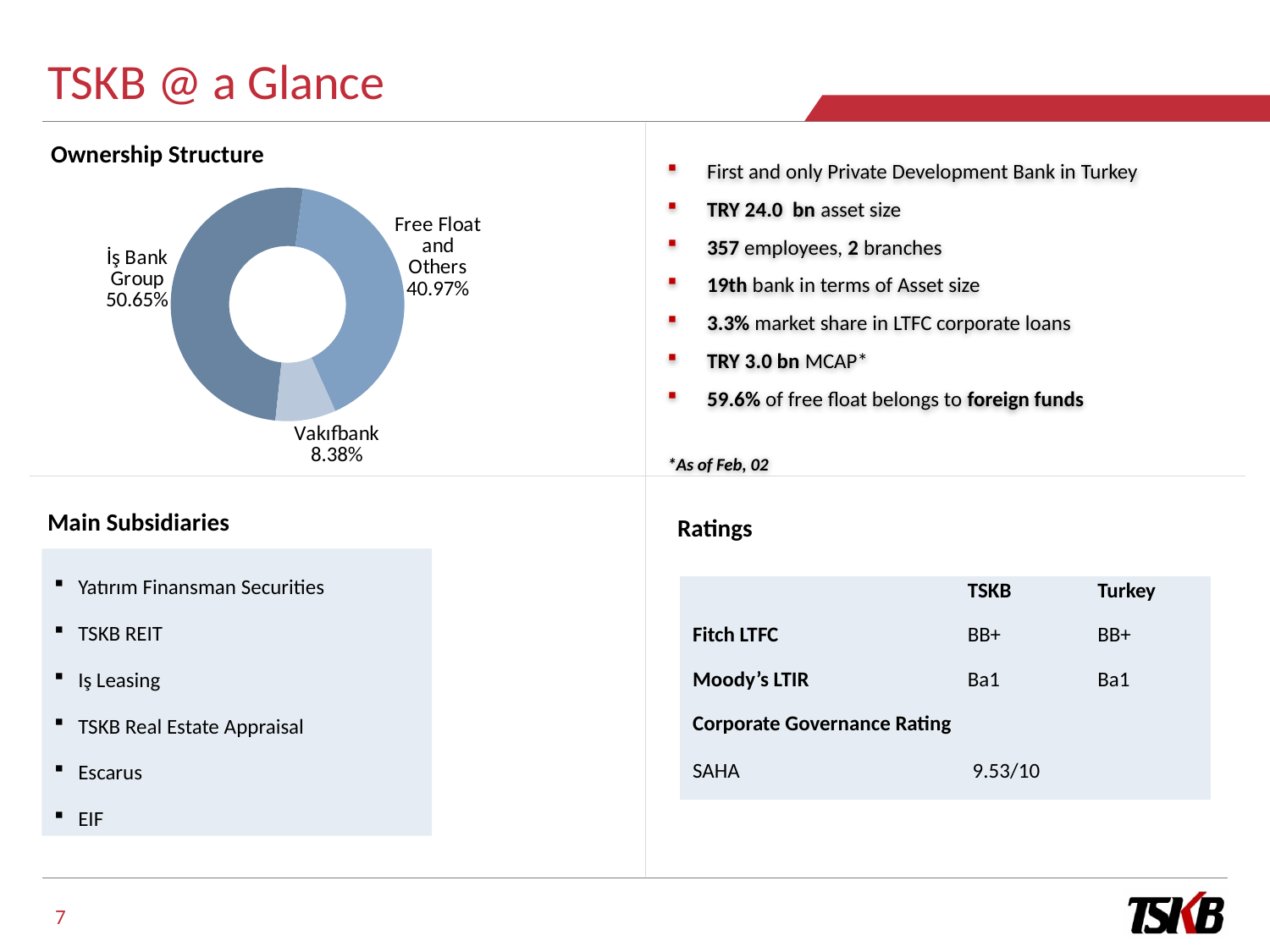
How many categories are shown in the Ownership Structure chart? 3 What share of ownership is held by Free Float and Others in the Ownership Structure chart? 40.97% What is the title of the chart on the slide? Ownership Structure What share of ownership does Vakıfbank hold in the Ownership Structure chart? 8.38% Which is larger in the Ownership Structure chart: the Vakıfbank share or the Free Float and Others share? Free Float and Others What is the difference in percentage points between the İş Bank Group share and the Free Float and Others share in the Ownership Structure chart? 9.68 What share of ownership does İş Bank Group hold in the Ownership Structure chart? 50.65% What is the combined share of İş Bank Group and Vakıfbank in the Ownership Structure chart? 59.03% What type of chart is the Ownership Structure chart? Doughnut (pie) chart Which category has the largest share in the Ownership Structure chart? İş Bank Group Is the İş Bank Group share in the Ownership Structure chart greater or less than 50%? greater Which category has the smallest share in the Ownership Structure chart? Vakıfbank